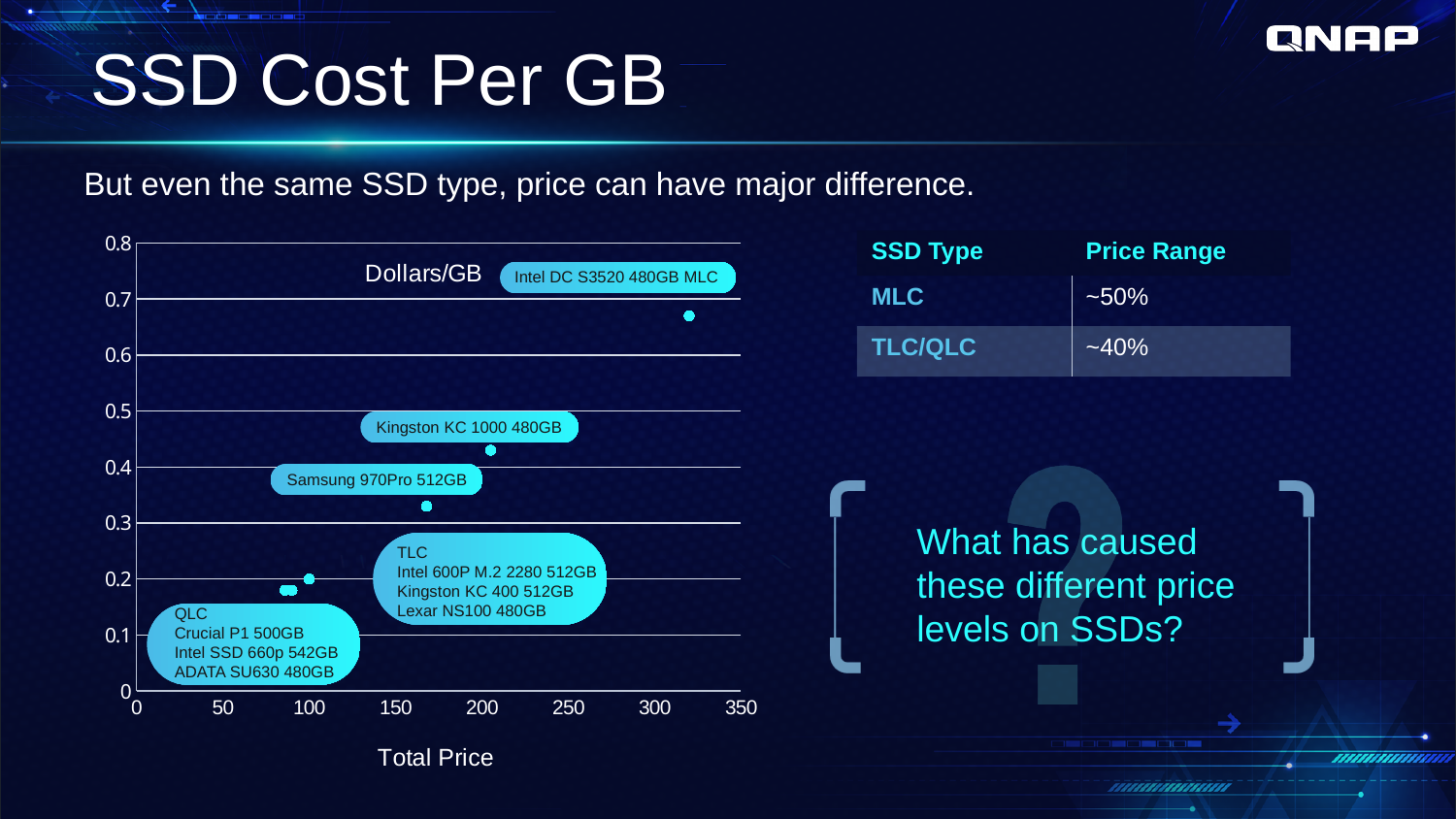
Is the Total Price for Samsung 970Pro 512GB greater or less than 200? less Which has a higher Dollars/GB value, Intel DC S3520 480GB MLC or Kingston KC 1000 480GB? Intel DC S3520 480GB MLC Is the Total Price for Intel DC S3520 480GB MLC greater or less than 300? greater What unit label is shown at the top of the chart for the y axis? Dollars/GB Is the Dollars/GB value for Samsung 970Pro 512GB greater or less than 0.4? less Which has a higher Dollars/GB value, Kingston KC 1000 480GB or Samsung 970Pro 512GB? Kingston KC 1000 480GB What is the title of the x axis of the chart? Total Price As Total Price increases along the x axis, do the Dollars/GB values generally rise or fall? rise Which SSD has the highest Dollars/GB value in the chart? Intel DC S3520 480GB MLC What kind of chart is shown on the slide? scatter chart